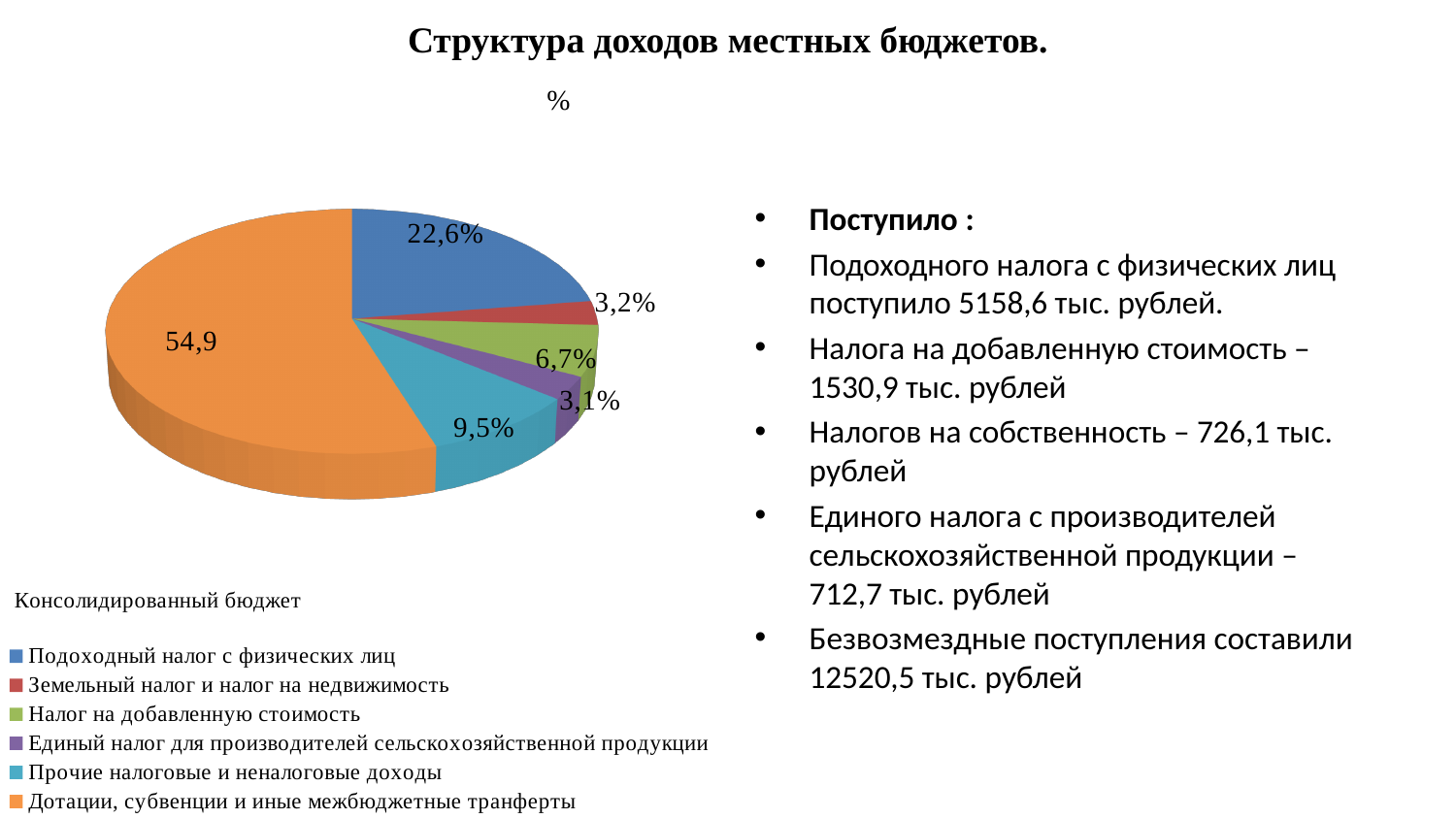
Which category has the smallest slice of the pie? Единый налог для производителей сельскохозяйственной продукции What share is shown for "Прочие налоговые и неналоговые доходы"? 9,5% What is the difference between the shares of "Подоходный налог с физических лиц" and "Прочие налоговые и неналоговые доходы"? 13,1% Which category has the largest slice of the pie? Дотации, субвенции и иные межбюджетные трансферты What kind of chart is shown on the slide? Pie chart What value is shown for "Дотации, субвенции и иные межбюджетные трансферты"? 54,9 Which is larger: the share for "Прочие налоговые и неналоговые доходы" or for "Налог на добавленную стоимость"? Прочие налоговые и неналоговые доходы What share is shown for "Земельный налог и налог на недвижимость"? 3,2% What share is shown for "Налог на добавленную стоимость"? 6,7% What colour is the slice for "Дотации, субвенции и иные межбюджетные трансферты"? Orange What share of the pie does "Подоходный налог с физических лиц" have? 22,6% How many categories does the legend list? 6